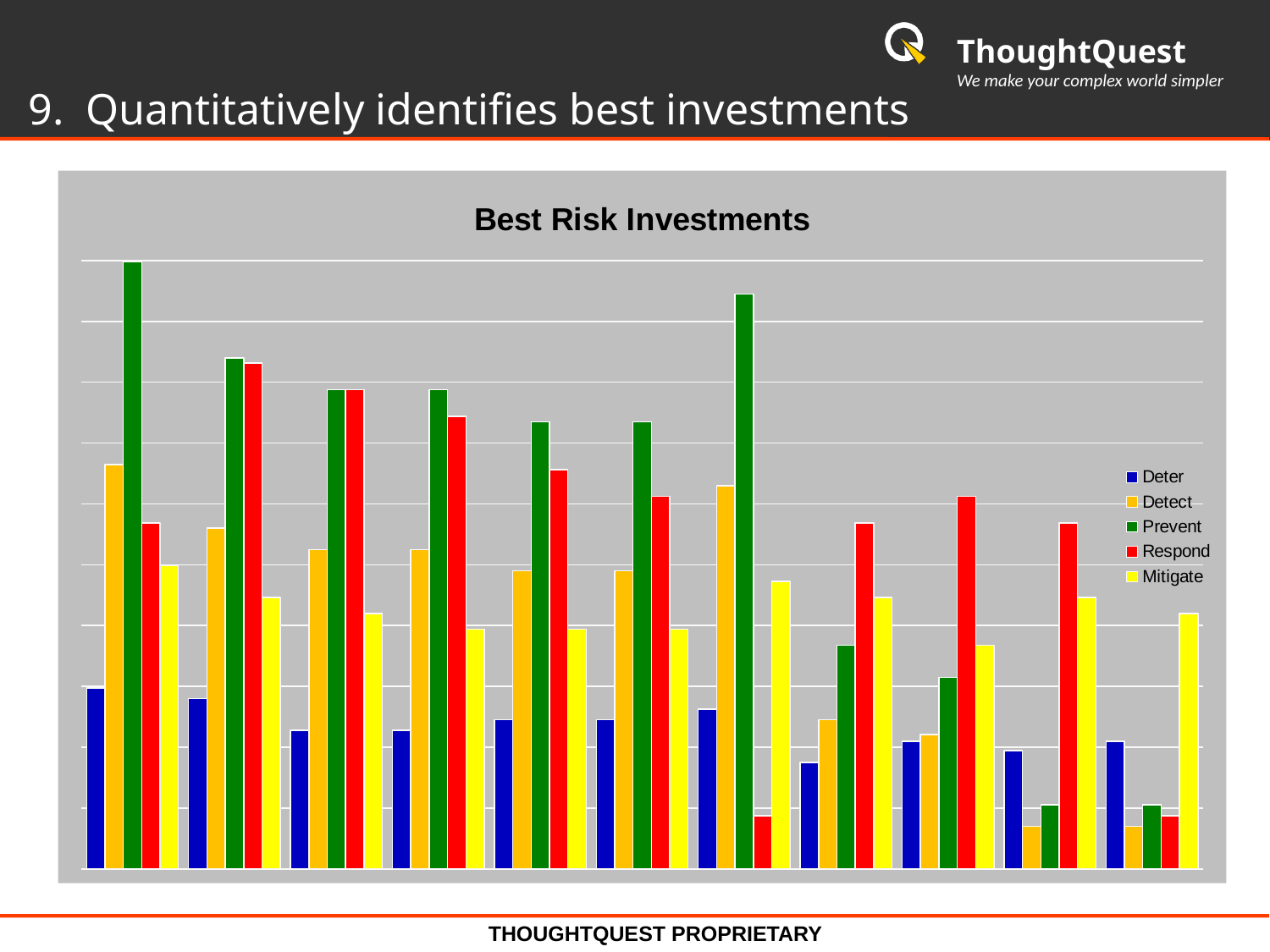
What is the title of the chart? Best Risk Investments How many groups of bars are plotted along the x axis? 11 What type of chart is shown on the slide? Bar chart How many series does the legend list? 5 Which series is shown in green in the legend? Prevent Which series has the tallest bar anywhere in the chart? Prevent